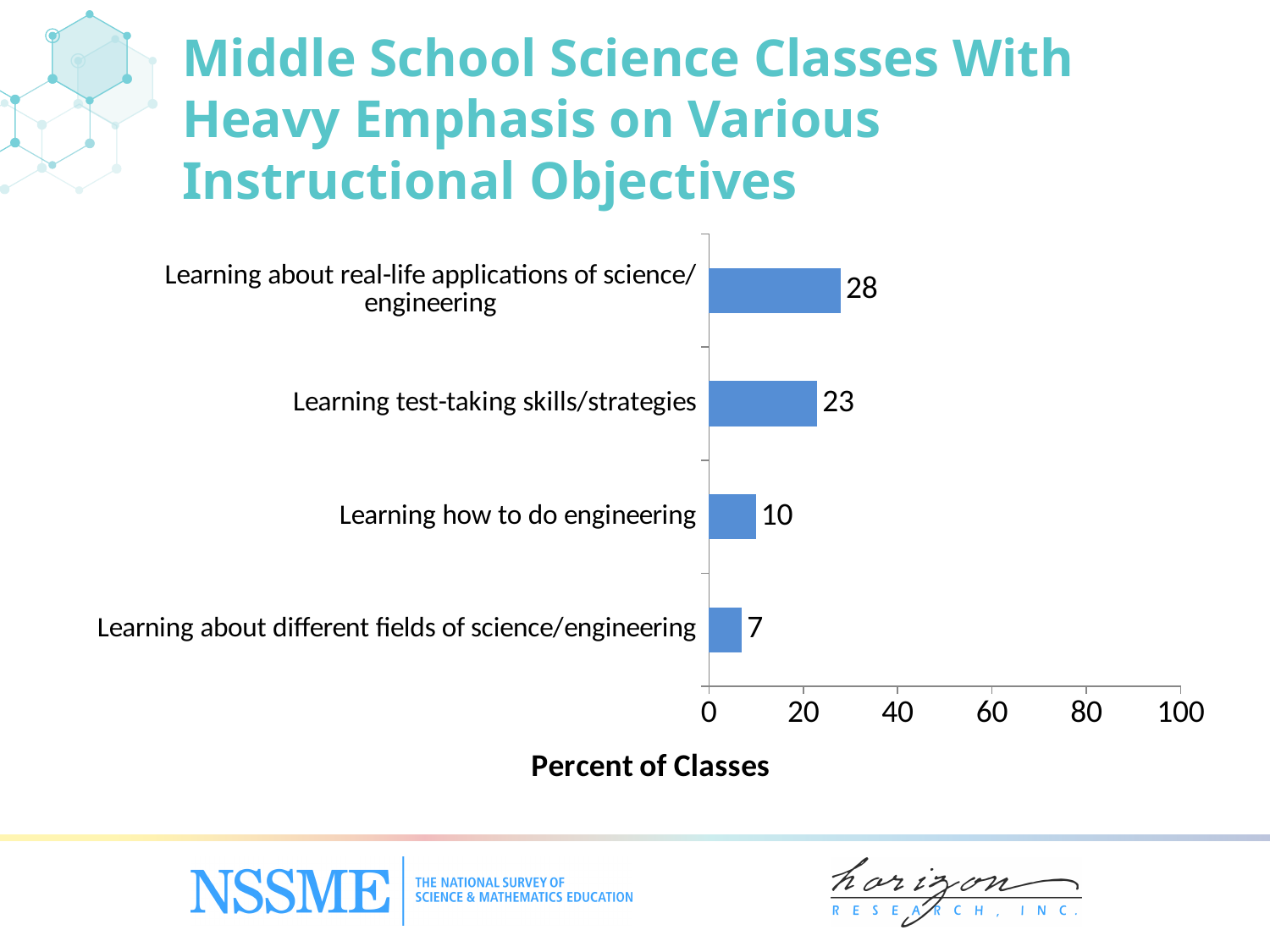
What percent of classes place heavy emphasis on learning about real-life applications of science/engineering? 28 Is the value for learning test-taking skills/strategies greater or less than 40? less Which instructional objective has the lowest percent of classes? Learning about different fields of science/engineering What is the value for learning test-taking skills/strategies? 23 What is the difference between the values for learning about real-life applications of science/engineering and learning test-taking skills/strategies? 5 What is the label of the horizontal axis? Percent of Classes How many instructional objectives are shown in the chart? 4 Which instructional objective has the highest percent of classes? Learning about real-life applications of science/engineering What percent of classes place heavy emphasis on learning how to do engineering? 10 What kind of chart is shown on the slide? Bar chart Which is larger: the value for learning how to do engineering or for learning about different fields of science/engineering? Learning how to do engineering What is the value for learning about different fields of science/engineering? 7